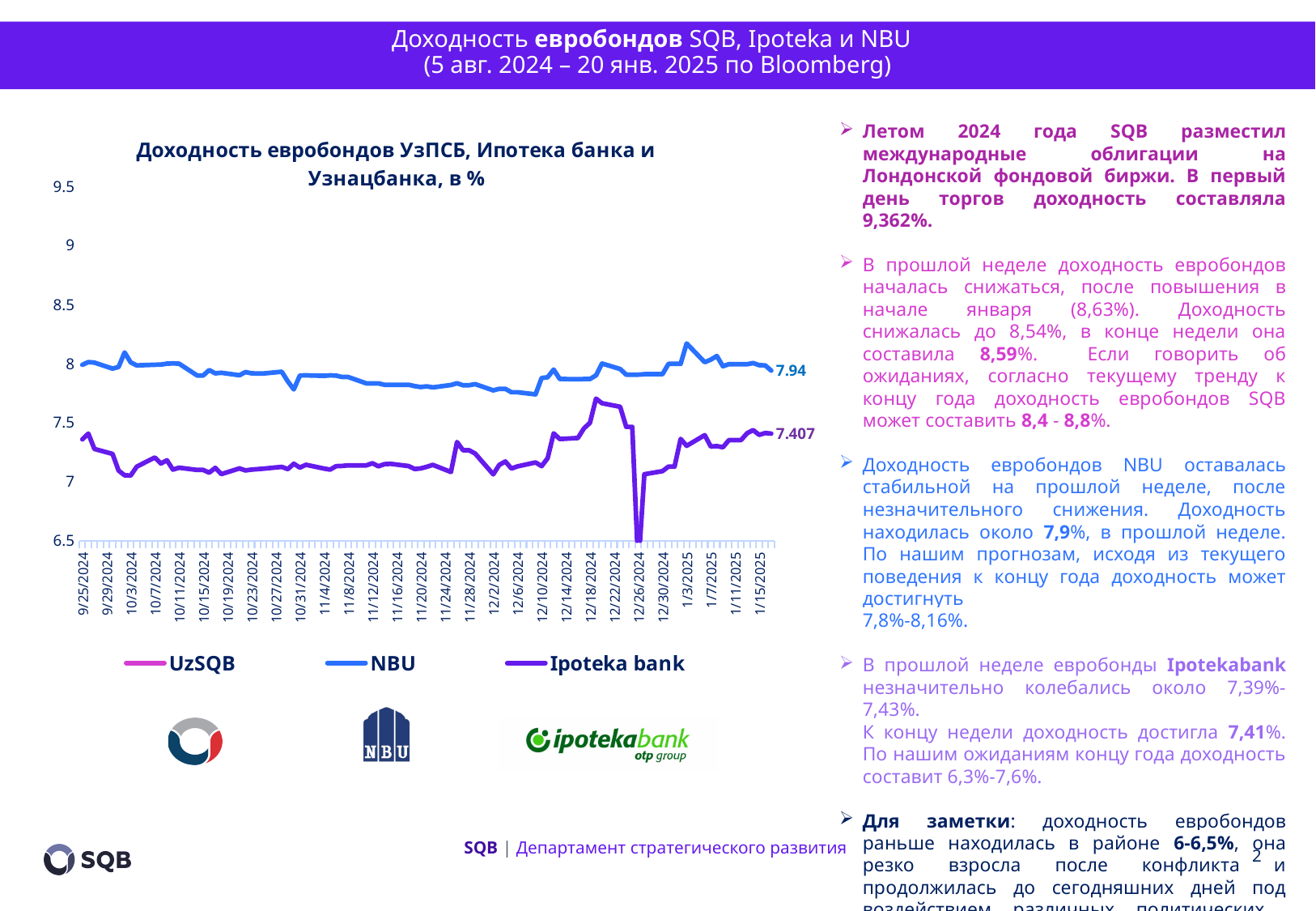
How many series does the chart legend list? 3 At the end of the period, which line is higher: NBU or Ipoteka bank? NBU Which legend entry is drawn in purple? Ipoteka bank What is the first date shown on the horizontal axis? 9/25/2024 Is the NBU line greater or less than 7.5 throughout the period? greater What is the difference between the final labelled values of NBU (7.94) and Ipoteka bank (7.407)? 0.533 Is the lowest point of the Ipoteka bank line (around 12/26/2024) greater or less than 7? less What is the last labelled value of the NBU line? 7.94 What is the last labelled value of the Ipoteka bank line? 7.407 What kind of chart is shown on the slide? line chart Which series has the higher yield across the whole period shown? NBU What is the highest tick value shown on the vertical axis? 9.5